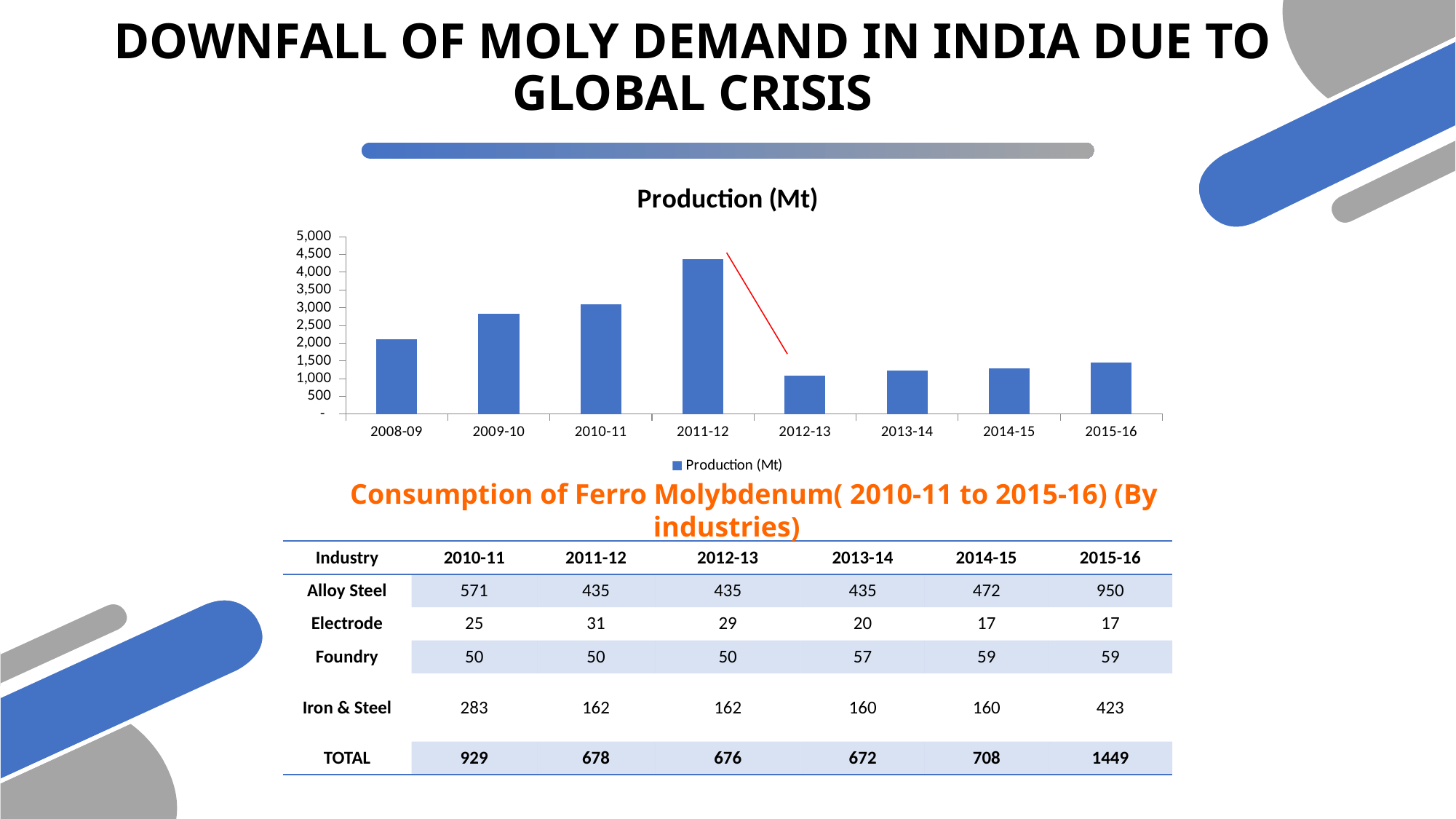
Which year has the highest production in the Production (Mt) chart? 2011-12 How many years are shown on the x axis of the Production (Mt) chart? 8 In the Production (Mt) chart, is the value for 2011-12 greater or less than 4,000? greater What is the legend entry shown below the Production (Mt) chart? Production (Mt) In the Production (Mt) chart, do the values rise or fall from 2012-13 to 2015-16? rise What kind of chart is the Production (Mt) chart? bar chart How many series does the legend of the Production (Mt) chart list? 1 In the Production (Mt) chart, which is larger, the value for 2009-10 or the value for 2015-16? 2009-10 Which year has the lowest production in the Production (Mt) chart? 2012-13 In the Production (Mt) chart, do the values rise or fall from 2008-09 to 2011-12? rise In the Production (Mt) chart, is the value for 2012-13 greater or less than 1,500? less